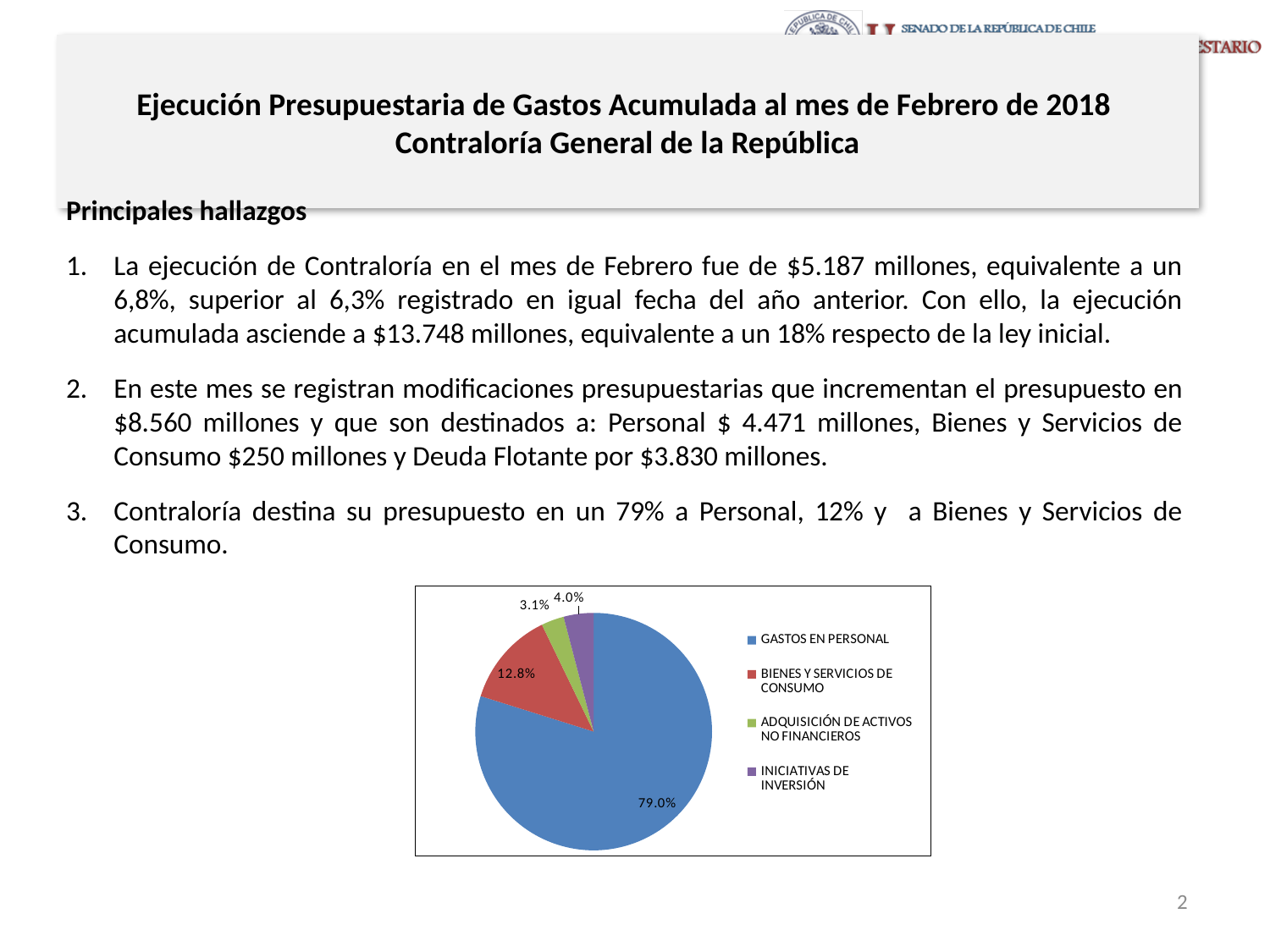
Which category is shown in green in the pie chart legend? ADQUISICIÓN DE ACTIVOS NO FINANCIEROS What share of the pie chart does ADQUISICIÓN DE ACTIVOS NO FINANCIEROS represent? 3.1% Which is larger in the pie chart, INICIATIVAS DE INVERSIÓN or ADQUISICIÓN DE ACTIVOS NO FINANCIEROS? INICIATIVAS DE INVERSIÓN What colour is the slice for GASTOS EN PERSONAL? Blue What type of chart is shown on the slide? Pie chart Which category has the largest slice in the pie chart? GASTOS EN PERSONAL Which category has the smallest slice in the pie chart? ADQUISICIÓN DE ACTIVOS NO FINANCIEROS What share of the pie chart does GASTOS EN PERSONAL represent? 79.0% What share of the pie chart does INICIATIVAS DE INVERSIÓN represent? 4.0% What is the difference in percentage points between GASTOS EN PERSONAL and BIENES Y SERVICIOS DE CONSUMO? 66.2 How many categories are shown in the pie chart? 4